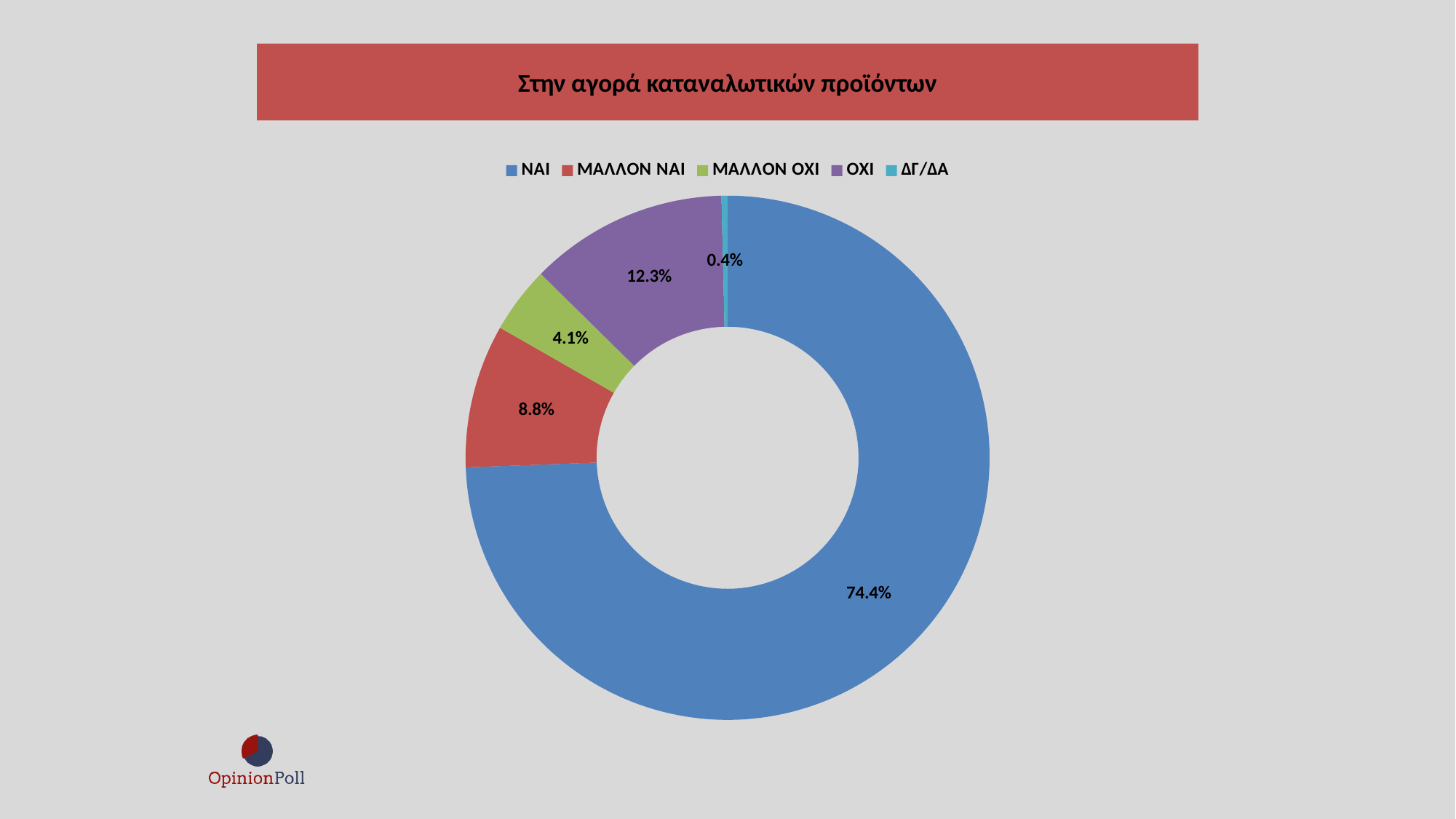
What percentage does the ΜΑΛΛΟΝ ΟΧΙ slice show? 4.1% What percentage does the ΜΑΛΛΟΝ ΝΑΙ slice show? 8.8% What percentage does the ΝΑΙ slice show? 74.4% What is the title of the chart? Στην αγορά καταναλωτικών προϊόντων What percentage does the ΟΧΙ slice show? 12.3% How many categories does the chart show? 5 What is the difference between the ΟΧΙ share and the ΜΑΛΛΟΝ ΝΑΙ share? 3.5% What kind of chart is shown on the slide? Doughnut (pie) chart What percentage does the ΔΓ/ΔΑ slice show? 0.4% Which is larger, the ΜΑΛΛΟΝ ΝΑΙ share or the ΜΑΛΛΟΝ ΟΧΙ share? ΜΑΛΛΟΝ ΝΑΙ Which category has the smallest share? ΔΓ/ΔΑ Which category has the largest share? ΝΑΙ